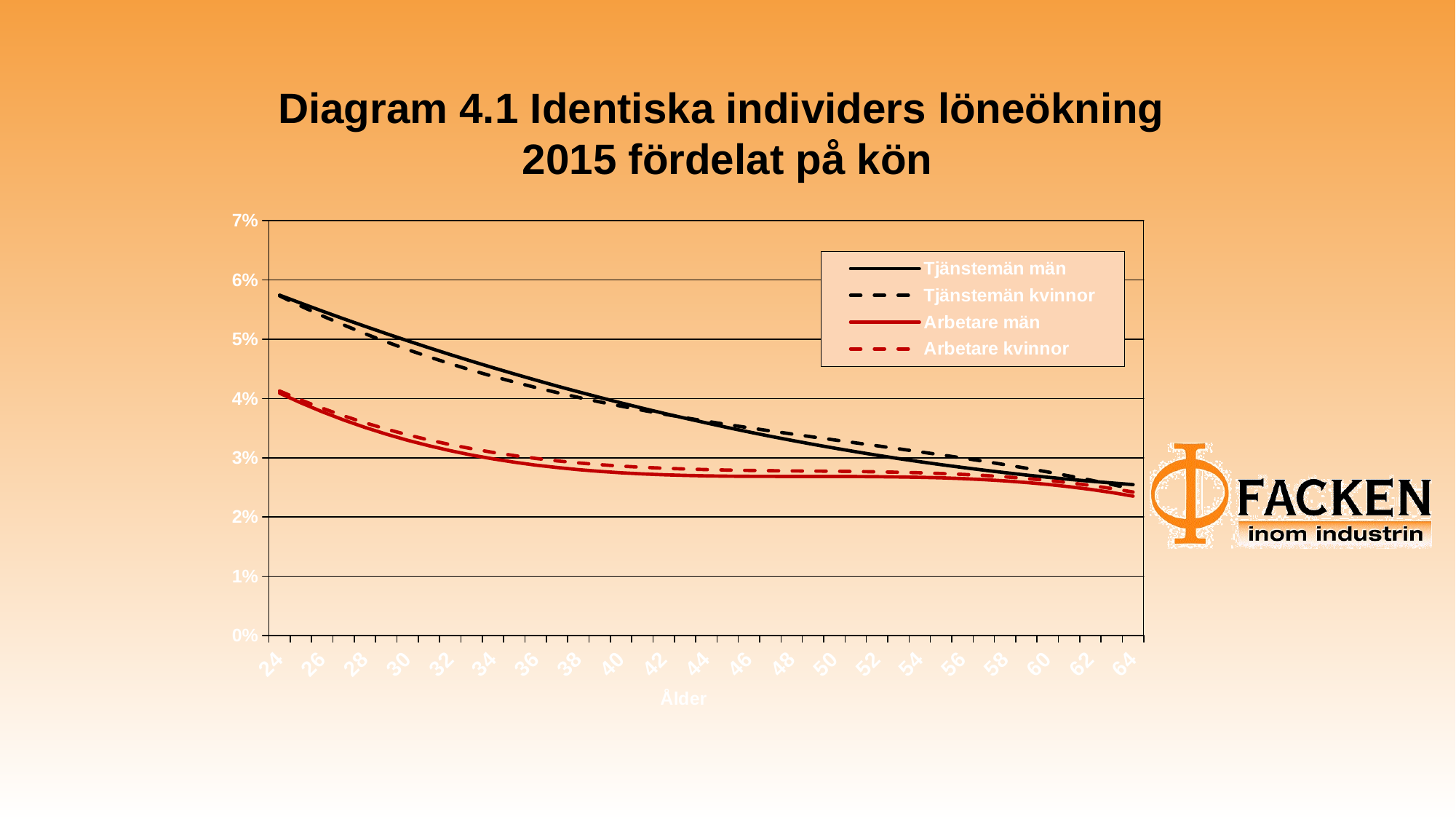
How many age ticks are shown on the x axis? 21 Is the value for Arbetare kvinnor at age 64 greater or less than 3%? less At age 50, which is larger: Tjänstemän kvinnor or Arbetare kvinnor? Tjänstemän kvinnor At age 24, which is larger: Tjänstemän män or Arbetare män? Tjänstemän män What kind of chart is shown on the slide? line chart What is the label of the x axis? Ålder Does the Tjänstemän män line rise or fall as age increases? fall What is the title of the chart? Diagram 4.1 Identiska individers löneökning 2015 fördelat på kön Is the value for Arbetare män at age 40 greater or less than 3%? less Is the value for Tjänstemän män at age 24 greater or less than 5%? greater How many series does the legend list? 4